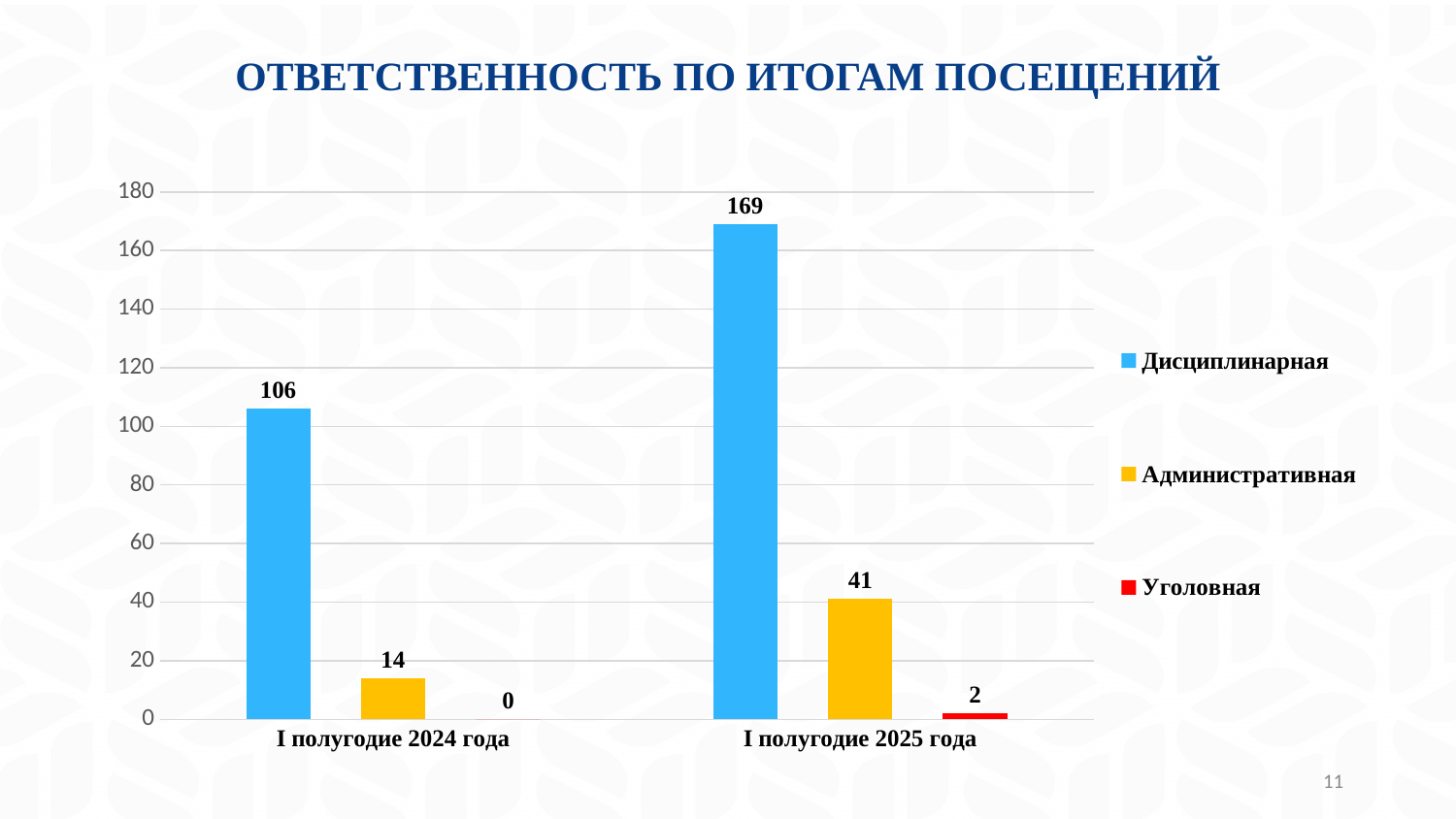
What kind of chart is shown on the slide? Bar chart What is the value for Административная in I полугодие 2024 года? 14 What is the value for Уголовная in I полугодие 2025 года? 2 What is the value for Дисциплинарная in I полугодие 2025 года? 169 What is the difference between the Дисциплинарная values for I полугодие 2025 года and I полугодие 2024 года? 63 Which is larger: Административная in I полугодие 2024 года or Административная in I полугодие 2025 года? I полугодие 2025 года Which series has the lowest value in I полугодие 2024 года? Уголовная How many categories are shown on the x axis? 2 Which series has the highest value in I полугодие 2025 года? Дисциплинарная What is the value for Дисциплинарная in I полугодие 2024 года? 106 How many series does the legend list? 3 What is the title of the slide? ОТВЕТСТВЕННОСТЬ ПО ИТОГАМ ПОСЕЩЕНИЙ